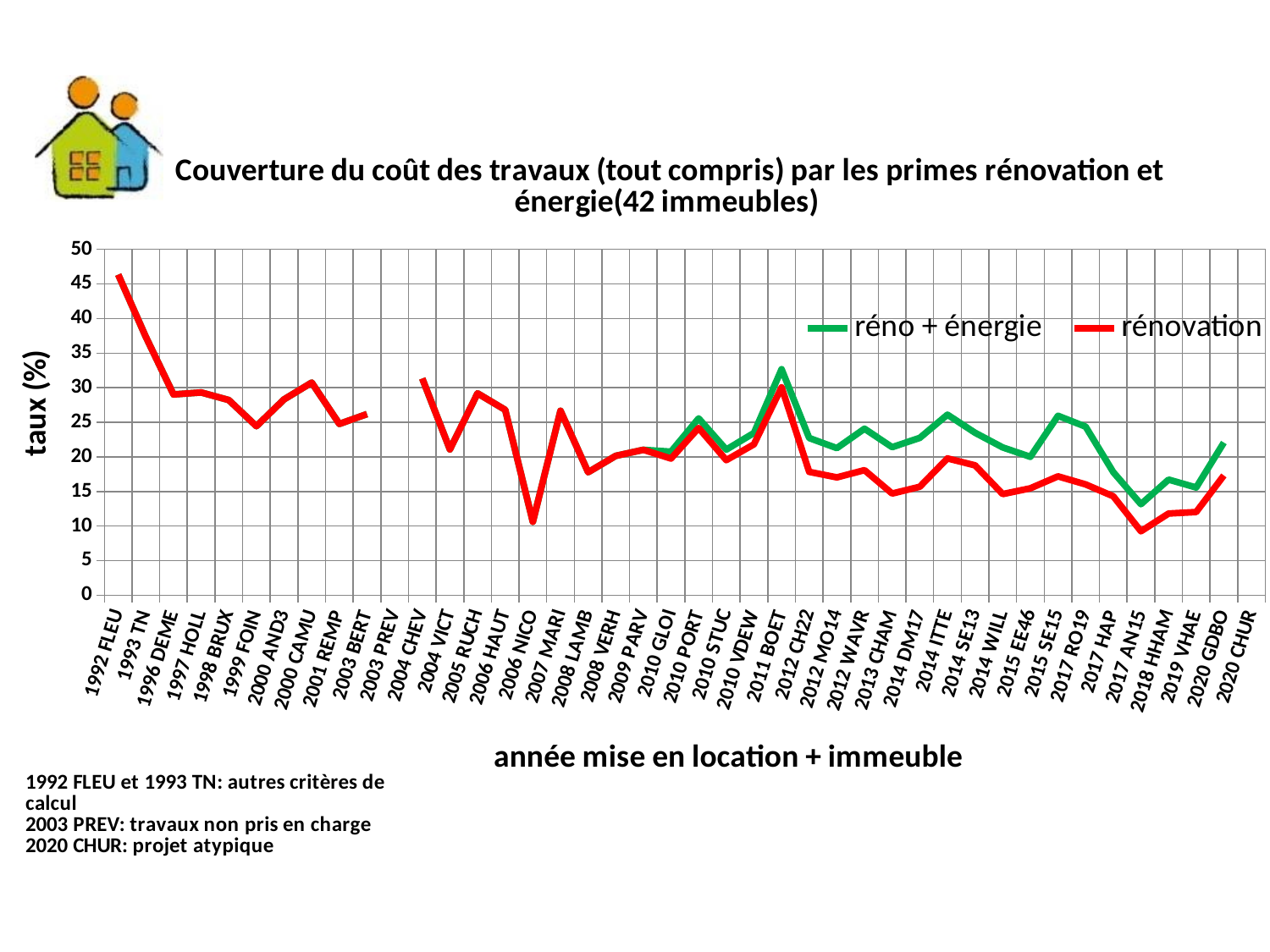
Is the 'rénovation' value for 2017 AN15 greater or less than 15? less Is the 'rénovation' value for 1992 FLEU greater or less than 40? greater How many categories are plotted along the x axis? 42 Is the 'réno + énergie' value for 2011 BOET greater or less than 30? greater Which category has the highest value for the 'rénovation' series? 1992 FLEU What kind of chart is shown on the slide? line chart For 2011 BOET, which series has the larger value, 'réno + énergie' or 'rénovation'? réno + énergie How many series does the legend list? 2 What is the title of the y axis? taux (%) Do the 'rénovation' values generally rise or fall from 1992 FLEU to 2020 GDBO? fall